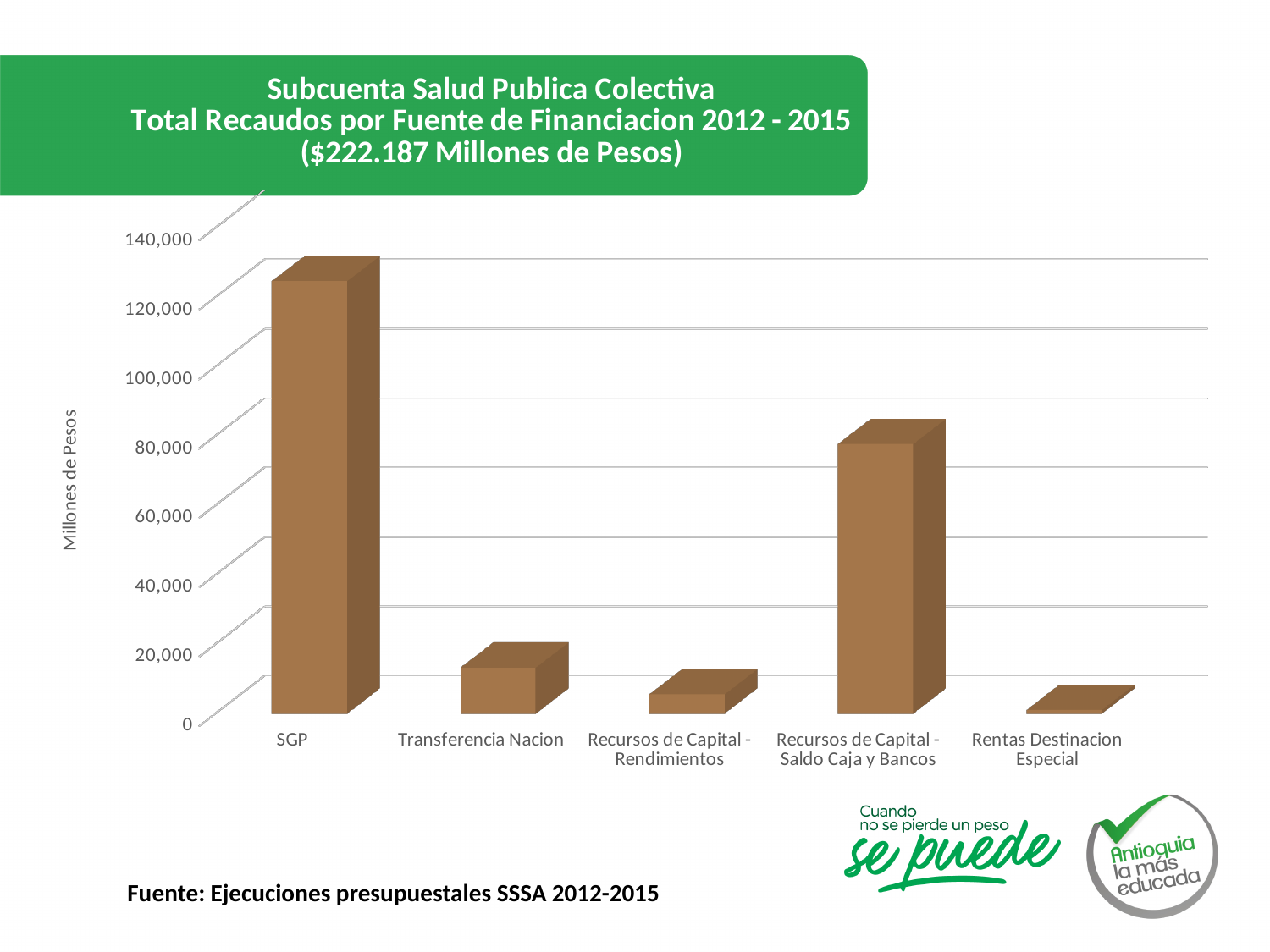
Is the value for Recursos de Capital - Saldo Caja y Bancos greater or less than 60,000? greater Which is larger, the value for Transferencia Nacion or the value for Recursos de Capital - Rendimientos? Transferencia Nacion What total amount is given in parentheses in the chart title? $222.187 Millones de Pesos Is the value for Transferencia Nacion greater or less than 20,000? less Is the value for SGP greater or less than 100,000? greater Which funding source has the highest total recaudos? SGP Which funding source has the lowest total recaudos? Rentas Destinacion Especial Which is larger, the value for SGP or the value for Recursos de Capital - Saldo Caja y Bancos? SGP What kind of chart is shown on the slide? Bar chart How many funding source categories are shown on the x axis? 5 What is the label of the vertical axis? Millones de Pesos